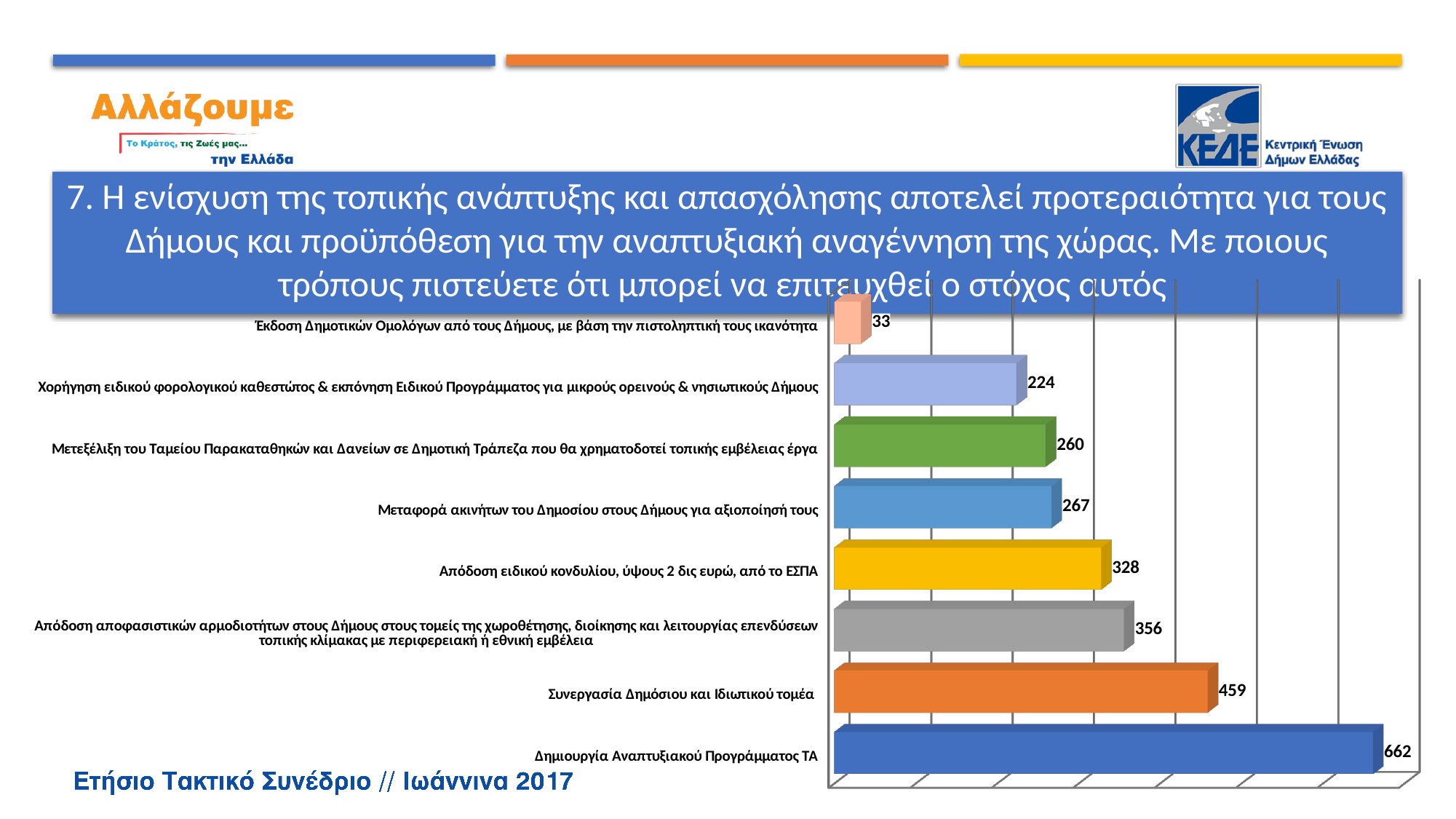
Which category has the lowest value? Έκδοση Δημοτικών Ομολόγων από τους Δήμους, με βάση την πιστοληπτική τους ικανότητα What is the value for "Απόδοση ειδικού κονδυλίου, ύψους 2 δις ευρώ, από το ΕΣΠΑ"? 328 What is the difference between the values for "Απόδοση ειδικού κονδυλίου, ύψους 2 δις ευρώ, από το ΕΣΠΑ" and "Μετεξέλιξη του Ταμείου Παρακαταθηκών και Δανείων σε Δημοτική Τράπεζα που θα χρηματοδοτεί τοπικής εμβέλειας έργα"? 68 How many categories are shown in the chart? 8 What is the value for "Μεταφορά ακινήτων του Δημοσίου στους Δήμους για αξιοποίησή τους"? 267 What is the value for "Συνεργασία Δημόσιου και Ιδιωτικού τομέα"? 459 What is the value for "Δημιουργία Αναπτυξιακού Προγράμματος ΤΑ"? 662 What is the difference between the values for "Δημιουργία Αναπτυξιακού Προγράμματος ΤΑ" and "Συνεργασία Δημόσιου και Ιδιωτικού τομέα"? 203 What kind of chart is shown on the slide? Bar chart What colour is the bar for "Δημιουργία Αναπτυξιακού Προγράμματος ΤΑ"? Blue Which is larger: the value for "Συνεργασία Δημόσιου και Ιδιωτικού τομέα" or the value for "Απόδοση ειδικού κονδυλίου, ύψους 2 δις ευρώ, από το ΕΣΠΑ"? Συνεργασία Δημόσιου και Ιδιωτικού τομέα Which category has the highest value? Δημιουργία Αναπτυξιακού Προγράμματος ΤΑ